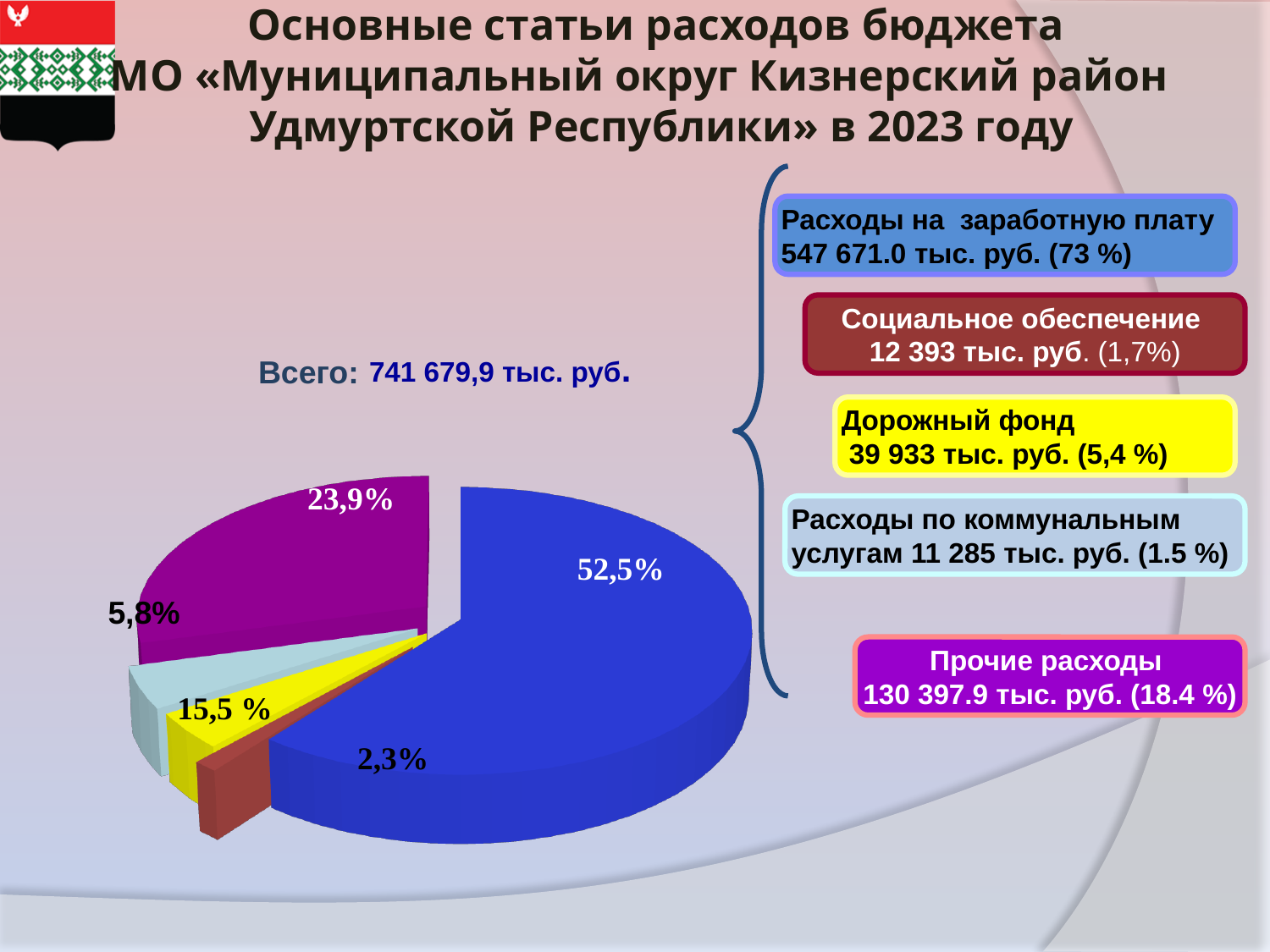
What is the largest percentage labelled on the pie chart? 52,5% What percentage is labelled on the purple slice of the pie chart? 23,9% How many slices does the pie chart have? 5 Is the blue slice's share greater or less than 50%? greater What type of chart is shown on the slide? pie chart What is the smallest percentage labelled on the pie chart? 2,3% What percentage is labelled on the blue slice of the pie chart? 52,5% Which slice is larger, the blue slice or the purple slice? the blue slice What total amount (Всего) is shown above the pie chart? 741 679,9 тыс. руб. According to the blue text box, what is the amount of expenses on wages (Расходы на заработную плату)? 547 671.0 тыс. руб. (73 %) What is the difference in percentage points between the blue slice (52,5%) and the purple slice (23,9%)? 28,6